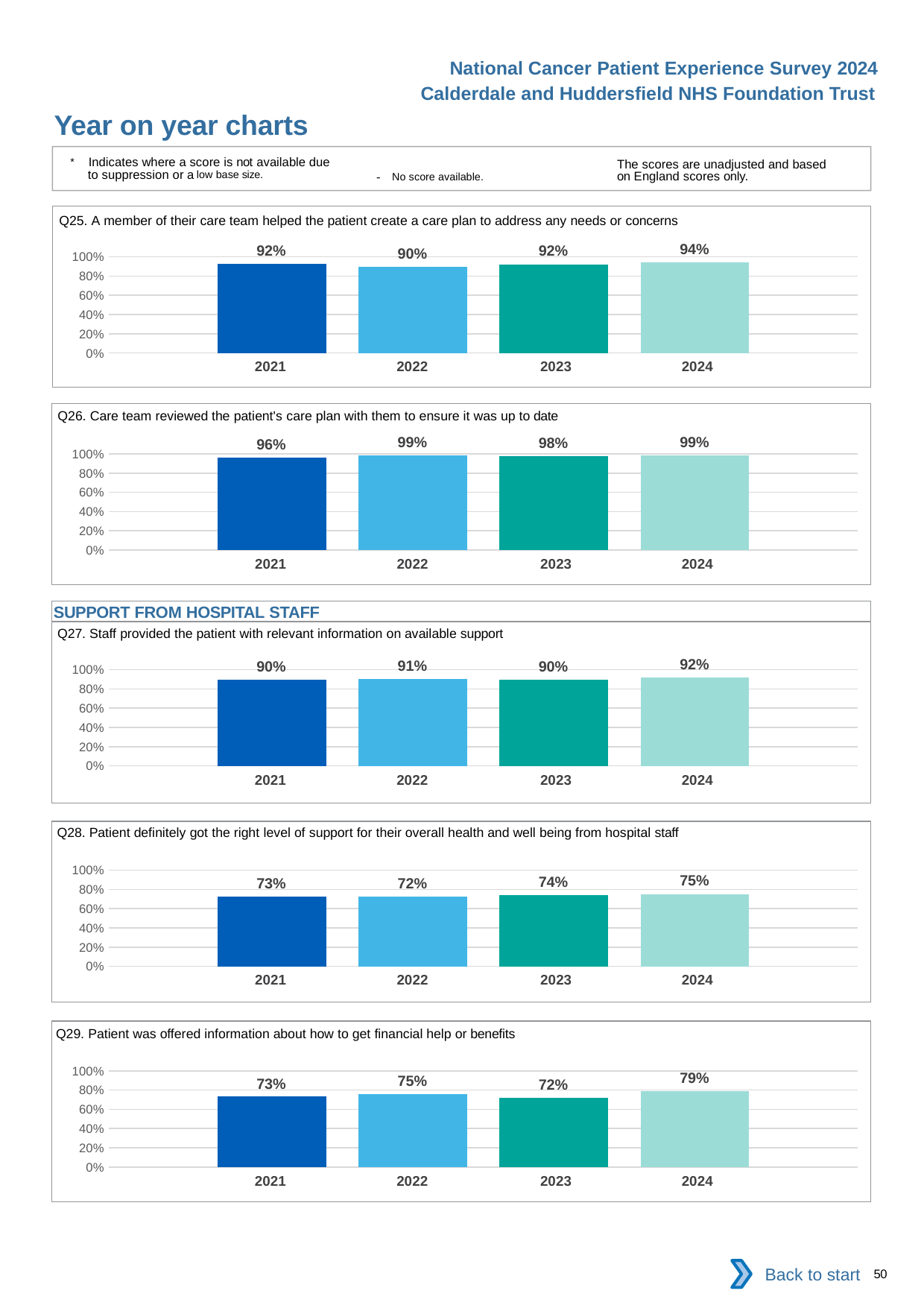
In the Q26 chart, what is the value for 2021? 96% In the Q27 chart, which year has the highest value? 2024 How many charts are shown on the slide? 5 What kind of chart is the Q26 chart? bar chart In the Q28 chart, which year has the lowest value? 2022 How many years are shown on the x axis of the Q25 chart? 4 In the Q29 chart, which is larger, the value for 2022 or the value for 2023? 2022 In the Q28 chart, do the values rise or fall from 2022 to 2024? rise In the Q28 chart, is the value for 2021 greater or less than 80%? less In the Q25 chart, what is the difference between the 2024 value and the 2022 value? 4% In the Q29 chart, what is the difference between the 2024 value and the 2023 value? 7% In the Q25 chart, what is the value for 2024? 94%